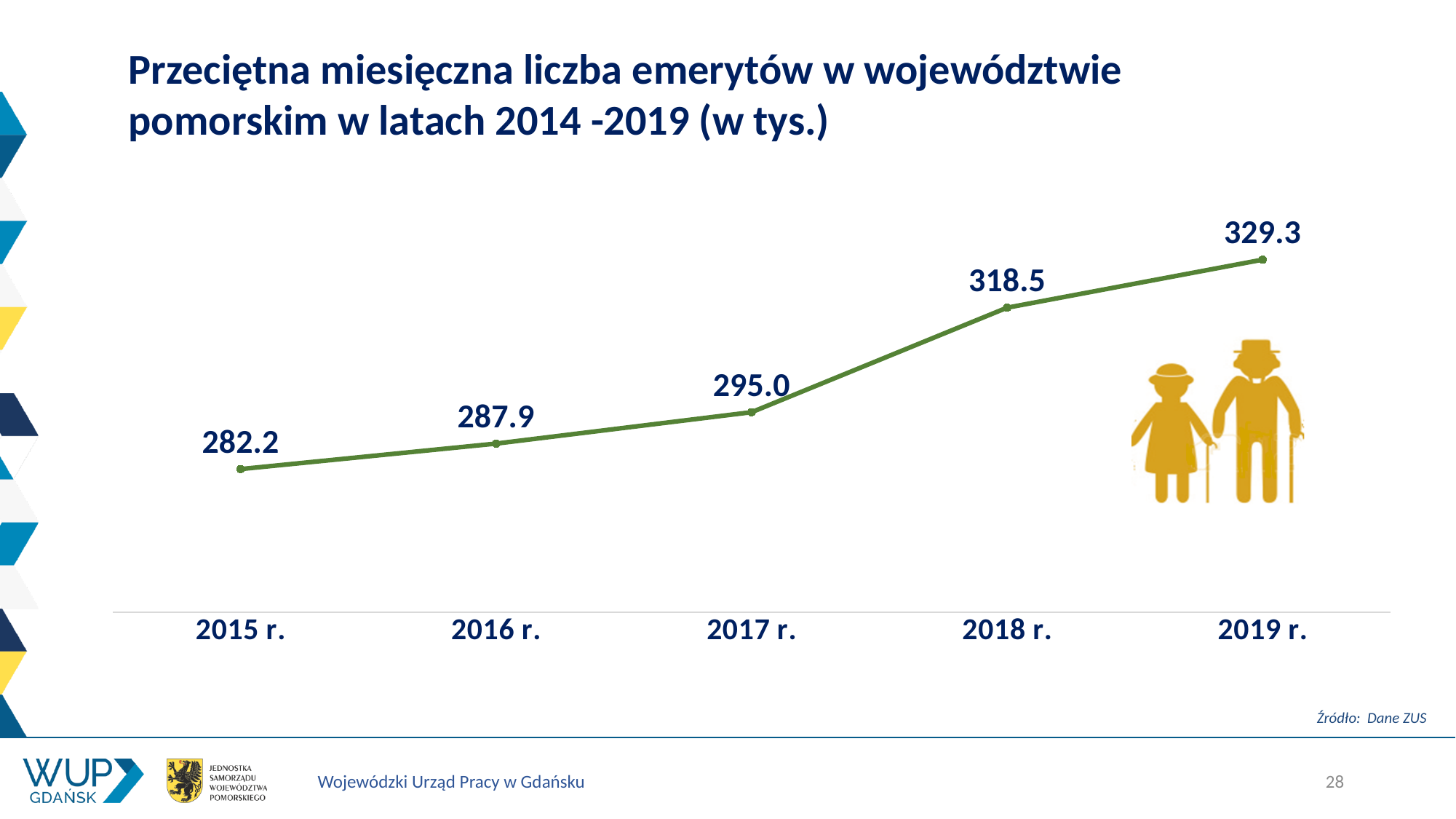
Which year has the highest value? 2019 r. What is the difference between the values for 2018 r. and 2017 r.? 23.5 Which is larger, the value for 2016 r. or the value for 2018 r.? 2018 r. What is the value for 2015 r.? 282.2 What kind of chart is shown on the slide? line chart Which year has the lowest value? 2015 r. What is the value for 2019 r.? 329.3 How many years are plotted on the chart? 5 What is the source given for the chart data? Dane ZUS What is the difference between the values for 2019 r. and 2015 r.? 47.1 Do the values rise or fall from 2015 r. to 2019 r.? rise What is the value for 2017 r.? 295.0